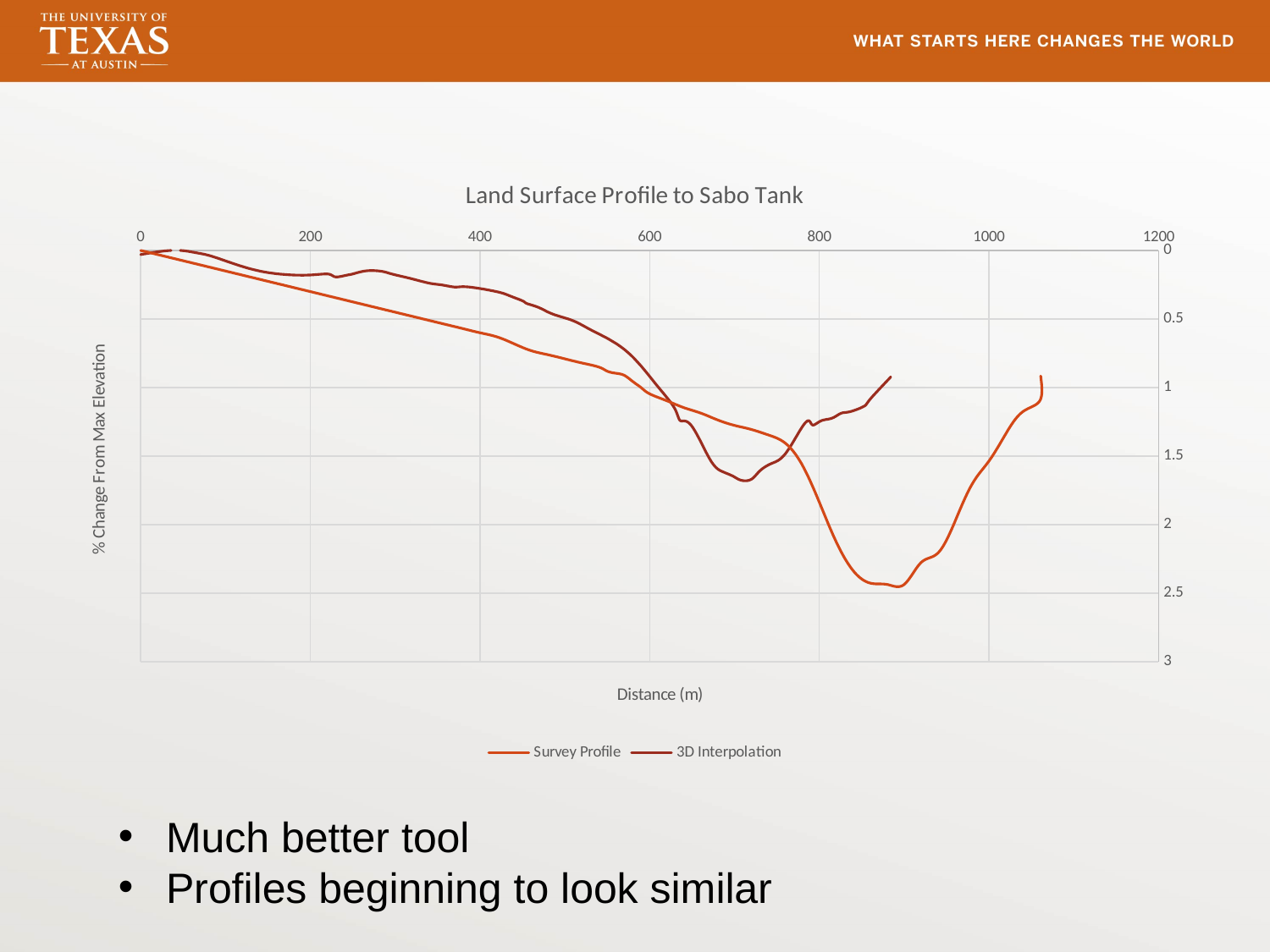
Is the 3D Interpolation value at a distance of 400 m greater or less than 0.5? less Is the 3D Interpolation value at a distance of 800 m greater or less than 1.5? less Is the Survey Profile value at a distance of 400 m greater or less than 0.5? greater How many series does the chart's legend list? 2 What is the label of the x axis? Distance (m) What type of chart is shown on the slide? line chart Between distances of 0 m and 600 m, does the Survey Profile's % change from max elevation value increase or decrease? increase Which series extends to the larger distance along the x axis, Survey Profile or 3D Interpolation? Survey Profile Which series reaches the larger maximum % change from max elevation, Survey Profile or 3D Interpolation? Survey Profile What is the title of the chart? Land Surface Profile to Sabo Tank